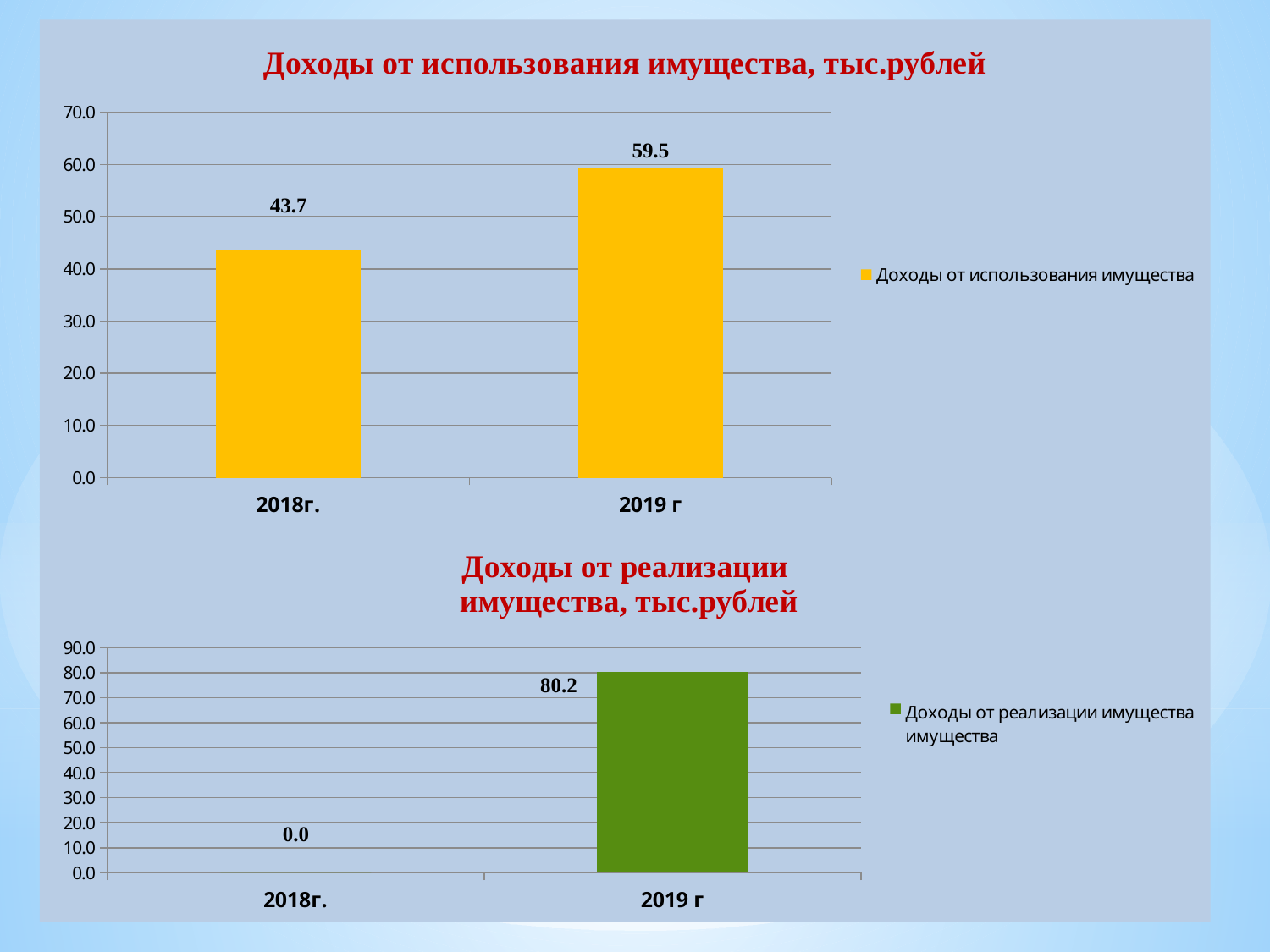
In the top chart 'Доходы от использования имущества, тыс.рублей', what is the value for 2019 г? 59.5 In the top chart 'Доходы от использования имущества, тыс.рублей', which year has the higher value? 2019 г What kind of chart is the top chart 'Доходы от использования имущества, тыс.рублей'? bar chart In the bottom chart 'Доходы от реализации имущества, тыс.рублей', what is the value for 2019 г? 80.2 In the bottom chart 'Доходы от реализации имущества, тыс.рублей', which year has the lower value? 2018г. In the top chart 'Доходы от использования имущества, тыс.рублей', what is the value for 2018г.? 43.7 In the top chart 'Доходы от использования имущества, тыс.рублей', what is the difference between the 2019 г and 2018г. values? 15.8 In the bottom chart 'Доходы от реализации имущества, тыс.рублей', what is the value for 2018г.? 0.0 What colour are the bars in the bottom chart 'Доходы от реализации имущества, тыс.рублей'? green In the bottom chart 'Доходы от реализации имущества, тыс.рублей', how many series does the legend list? 1 In the top chart 'Доходы от использования имущества, тыс.рублей', how many categories are shown on the x axis? 2 In the top chart 'Доходы от использования имущества, тыс.рублей', do the values rise or fall from 2018г. to 2019 г? rise